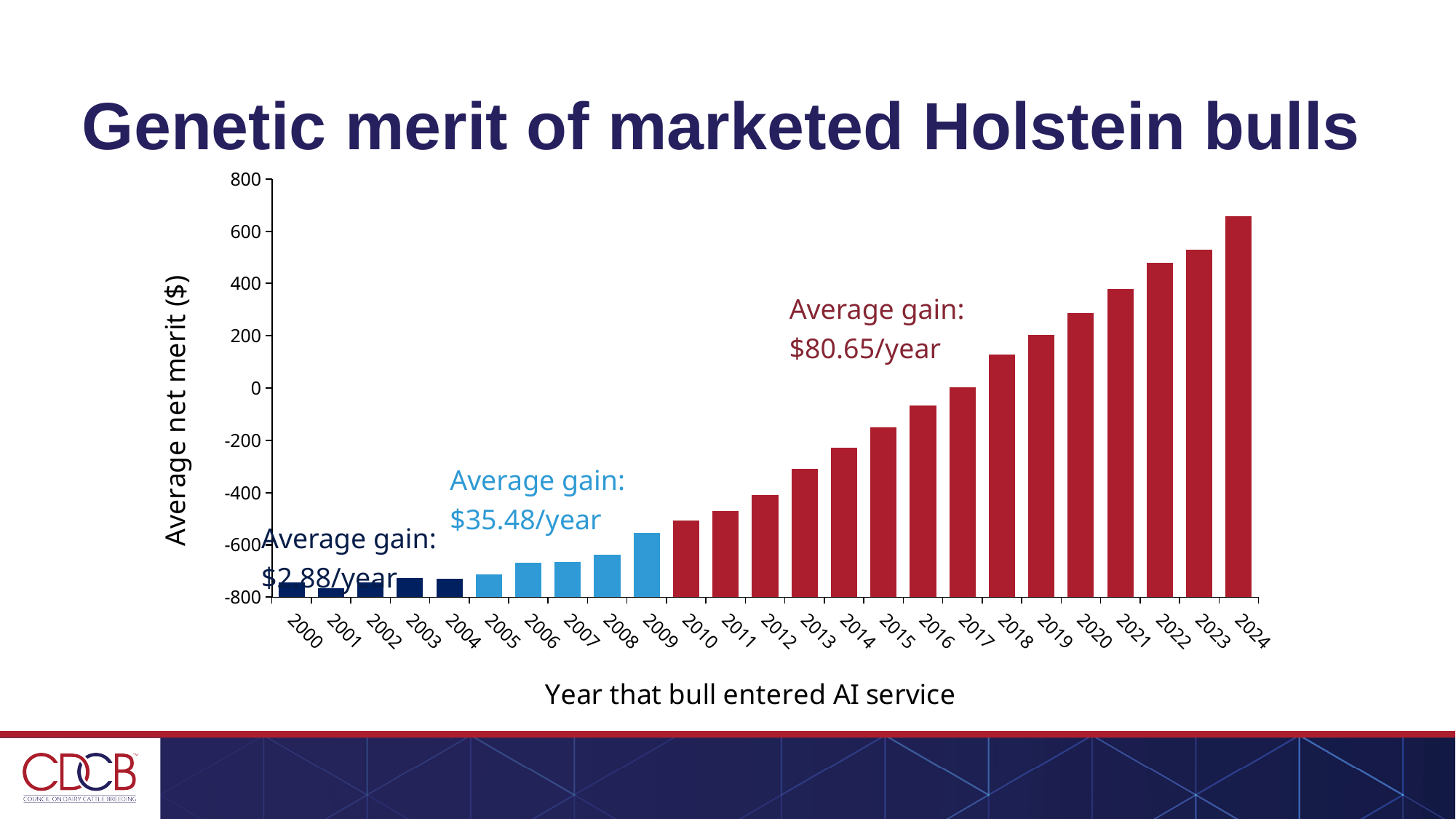
Is the value for 2020 greater or less than 200? greater What average gain per year is annotated for the red bars (2010 onward)? $80.65/year How many years (bars) are plotted on the x axis? 25 Which year has the highest average net merit? 2024 Is the value for 2024 greater or less than 600? greater What is the label on the x axis? Year that bull entered AI service What kind of chart is shown on the slide? bar chart Do the values generally rise or fall from 2000 to 2024? rise Is the value for 2010 greater or less than -400? less Which year has the larger average net merit, 2005 or 2019? 2019